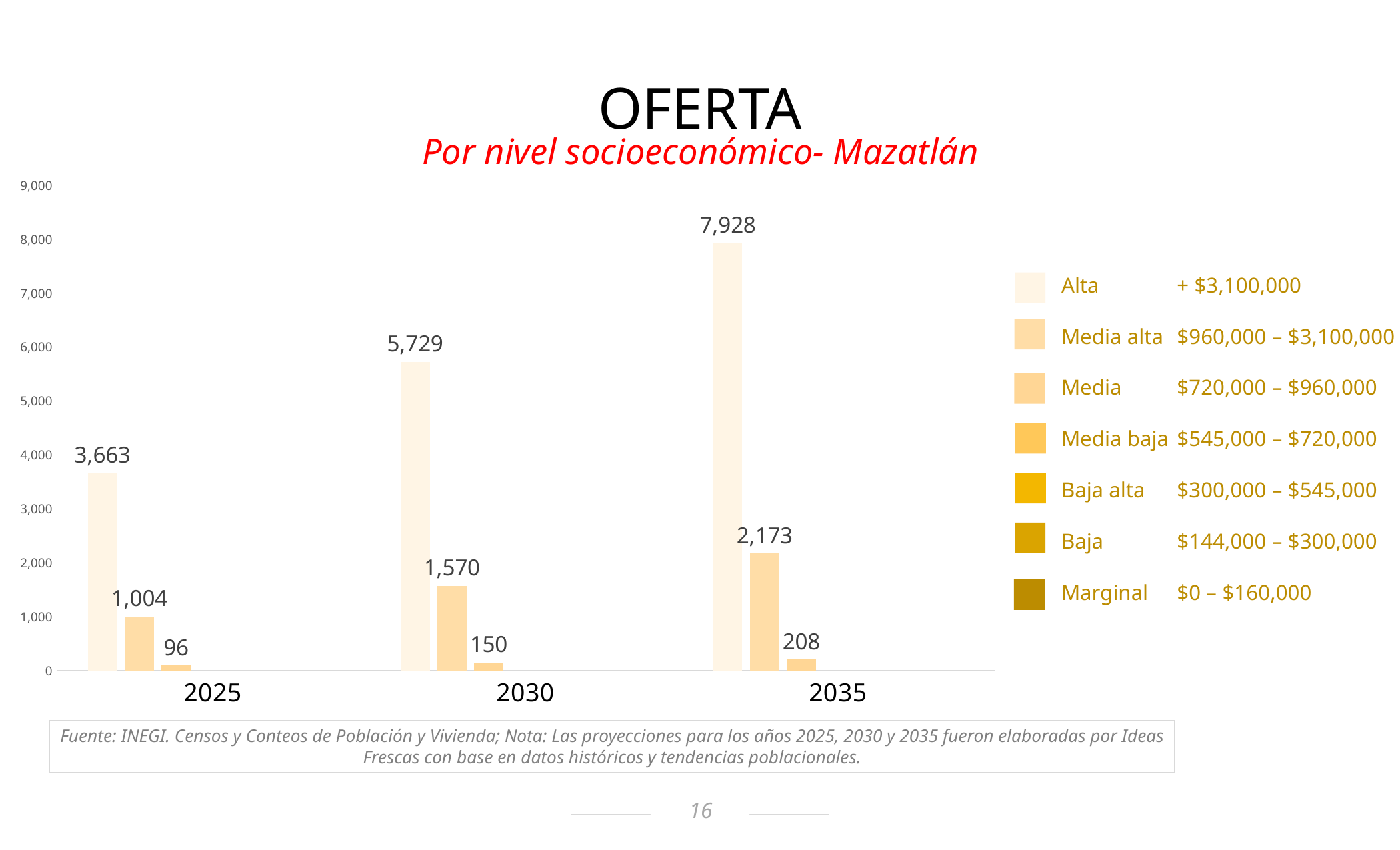
Which is larger: Media alta in 2030 or Media alta in 2035? Media alta in 2035 How many years are shown on the x axis? 3 Is the value for Alta in 2030 greater or less than 5,000? greater What is the difference between the Media alta values for 2035 and 2025? 1,169 What is the value for Alta in 2035? 7,928 What is the value for Media in 2030? 150 What is the difference between the Alta values for 2035 and 2030? 2,199 What kind of chart is shown on the slide? bar chart In which year is the Media value lowest? 2025 What is the value for Media alta in 2025? 1,004 In which year is the Alta value highest? 2035 How many series does the legend list? 7